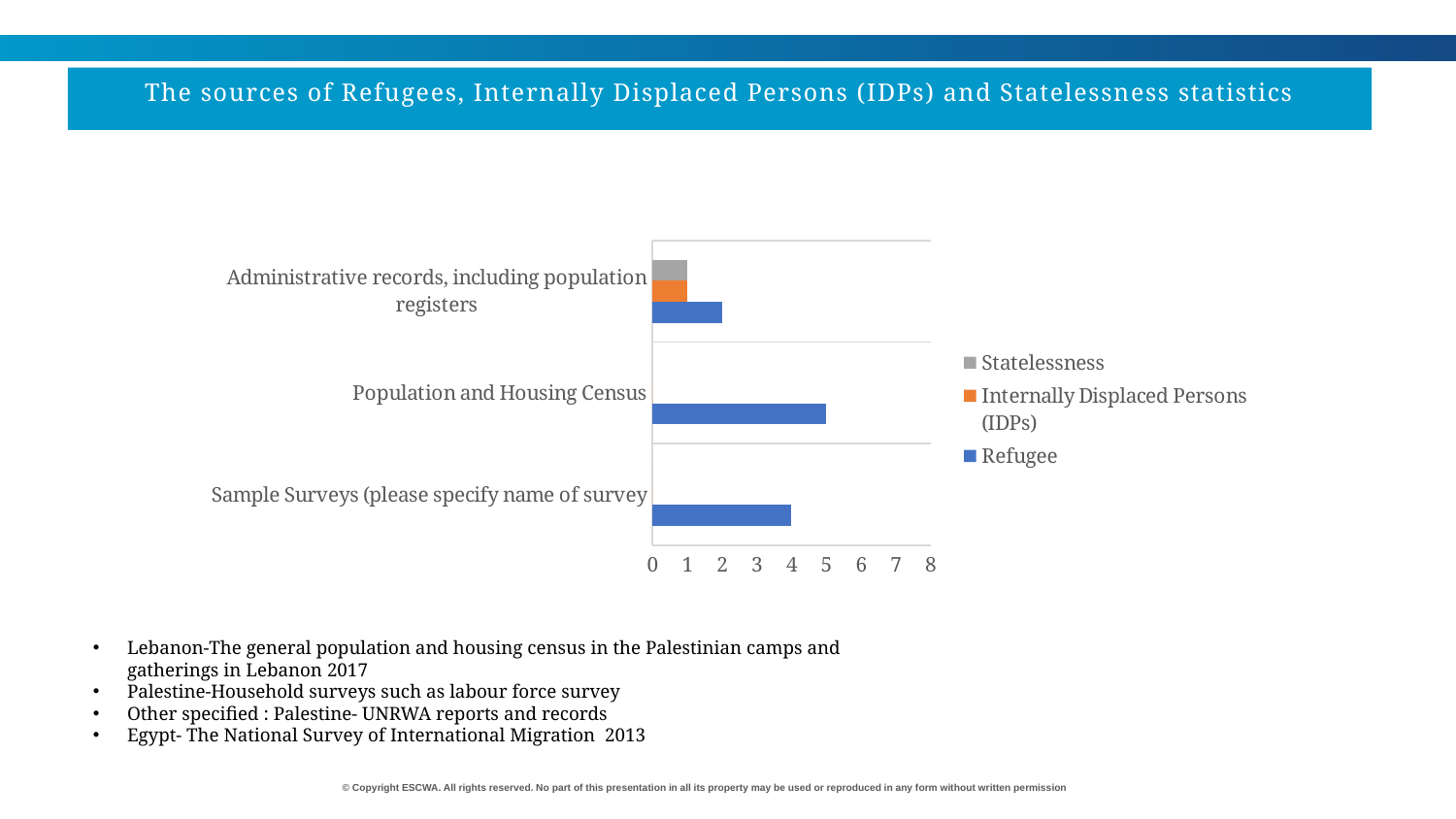
Is the Refugee value for Population and Housing Census greater or less than 4? greater Which series is shown in orange in the legend? Internally Displaced Persons (IDPs) Which category has the highest Refugee value? Population and Housing Census Which category has the lowest Refugee value? Administrative records, including population registers What is the Refugee value for Sample Surveys (please specify name of survey)? 4 What is the Refugee value for Population and Housing Census? 5 Which is larger: the Refugee value for Sample Surveys or the Refugee value for Administrative records, including population registers? Sample Surveys What is the Refugee value for Administrative records, including population registers? 2 How many categories are shown on the vertical axis of the chart? 3 What kind of chart is shown on the slide? bar chart What is the difference between the Refugee value for Population and Housing Census and the Refugee value for Administrative records, including population registers? 3 How many series does the legend list? 3